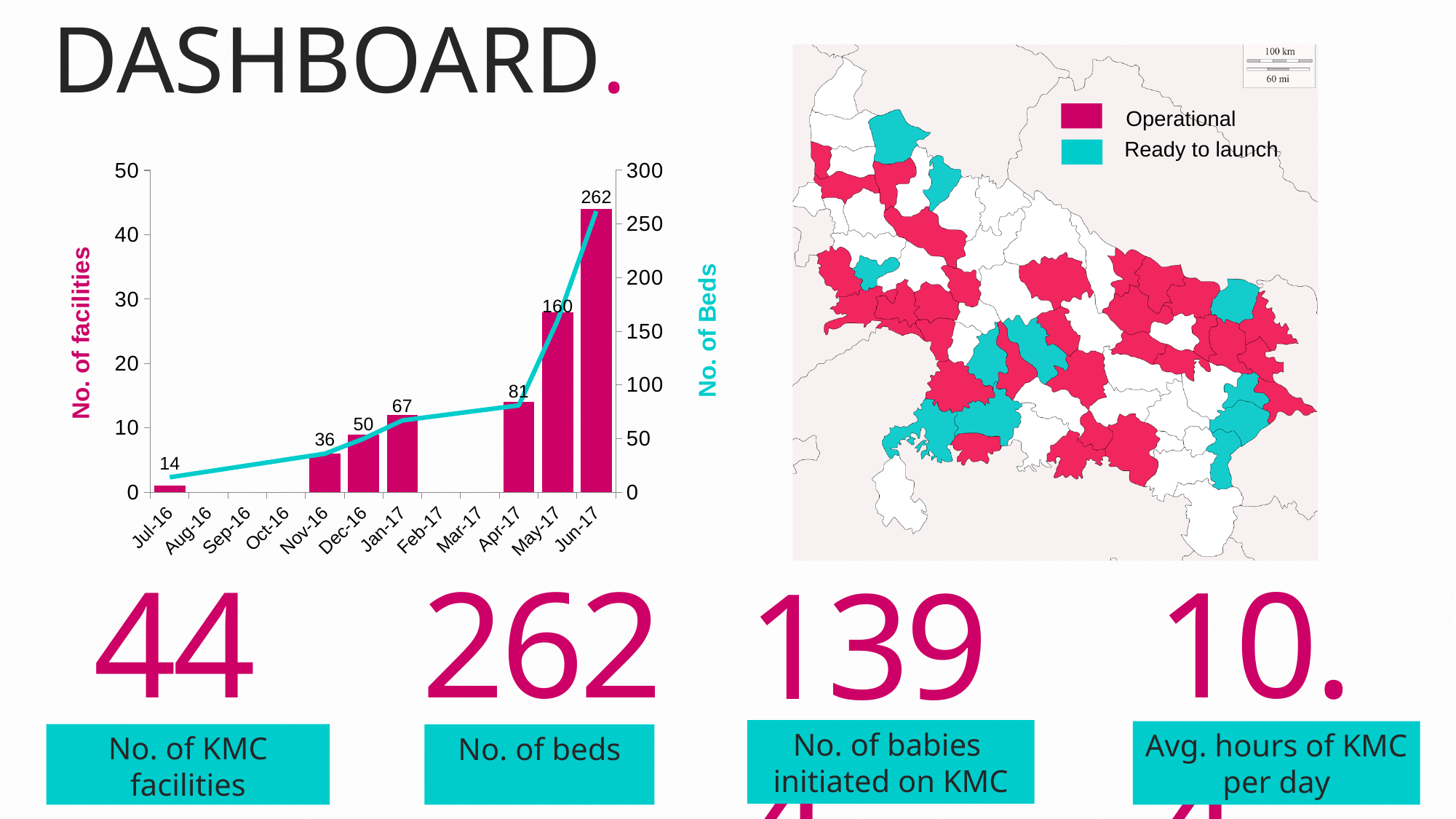
On the chart, which month has the highest No. of Beds? Jun-17 On the chart, what is the difference between the No. of Beds in Jun-17 and in May-17? 102 On the chart, what is the No. of Beds value labelled for Nov-16? 36 On the chart, is the No. of facilities bar for May-17 greater or less than 20? greater On the chart, what is the No. of Beds value labelled for Jun-17? 262 What is the label of the left vertical axis of the chart? No. of facilities On the chart, what is the No. of Beds value labelled for Apr-17? 81 On the chart, which is larger: the No. of Beds in Apr-17 or in Jan-17? Apr-17 On the chart, is the No. of facilities bar for Jan-17 greater or less than 20? less On the chart, which month has the lowest labelled No. of Beds? Jul-16 How many months are shown on the x axis of the chart? 12 On the chart, does the No. of Beds line rise or fall from Jul-16 to Jun-17? rise